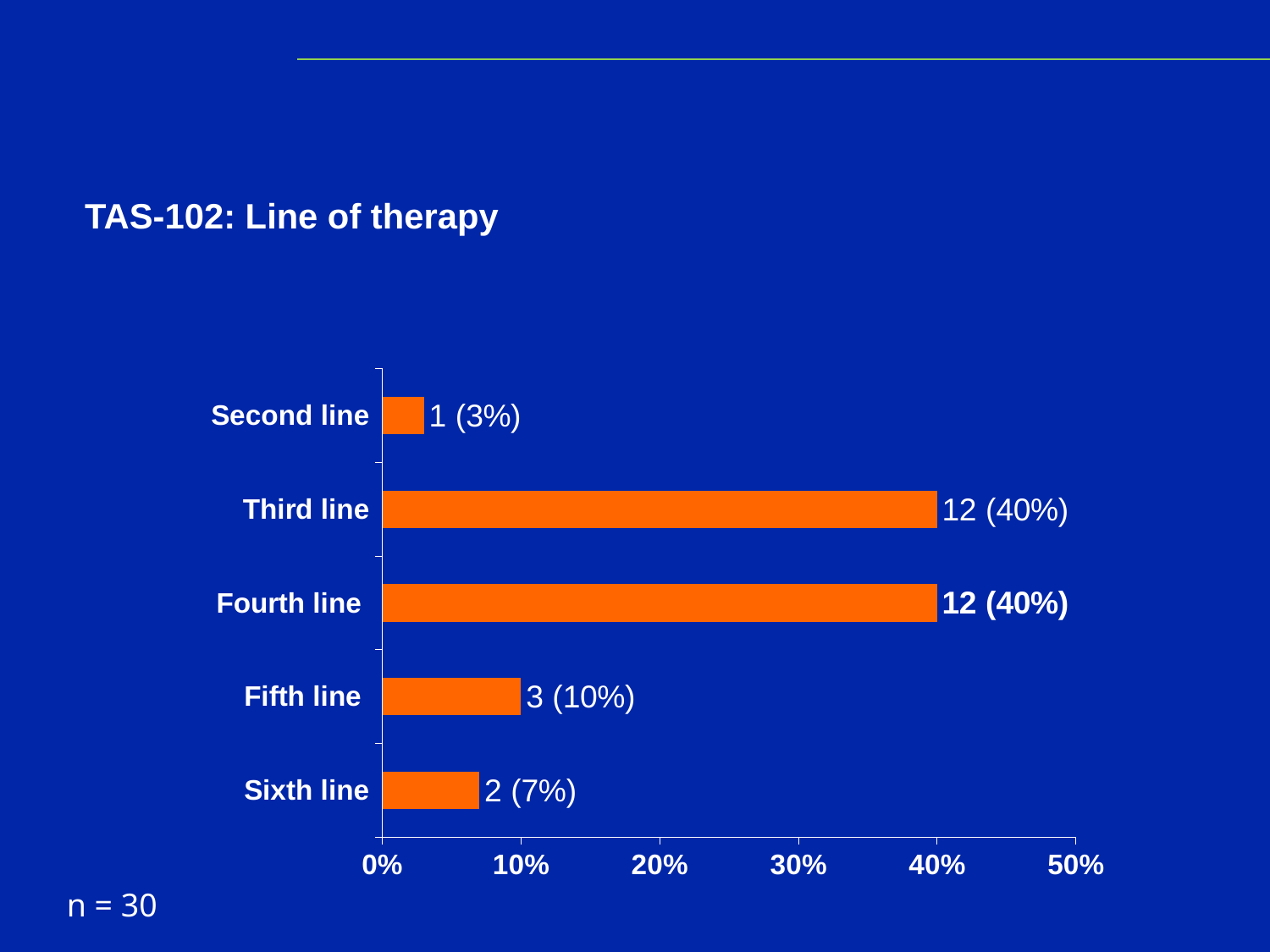
What is the title of the chart? TAS-102: Line of therapy What is the data label shown for Sixth line? 2 (7%) Is the value for Third line greater or less than 30%? greater What is the data label shown for Second line? 1 (3%) Which line of therapy has the lowest value? Second line What kind of chart is shown on the slide? bar chart What is the data label shown for Third line? 12 (40%) Which is larger, the value for Fifth line or the value for Sixth line? Fifth line What is the difference in percentage points between Fourth line and Fifth line? 30% How many lines of therapy are shown on the chart? 5 What is the sample size (n) noted on the slide? n = 30 What is the data label shown for Fifth line? 3 (10%)